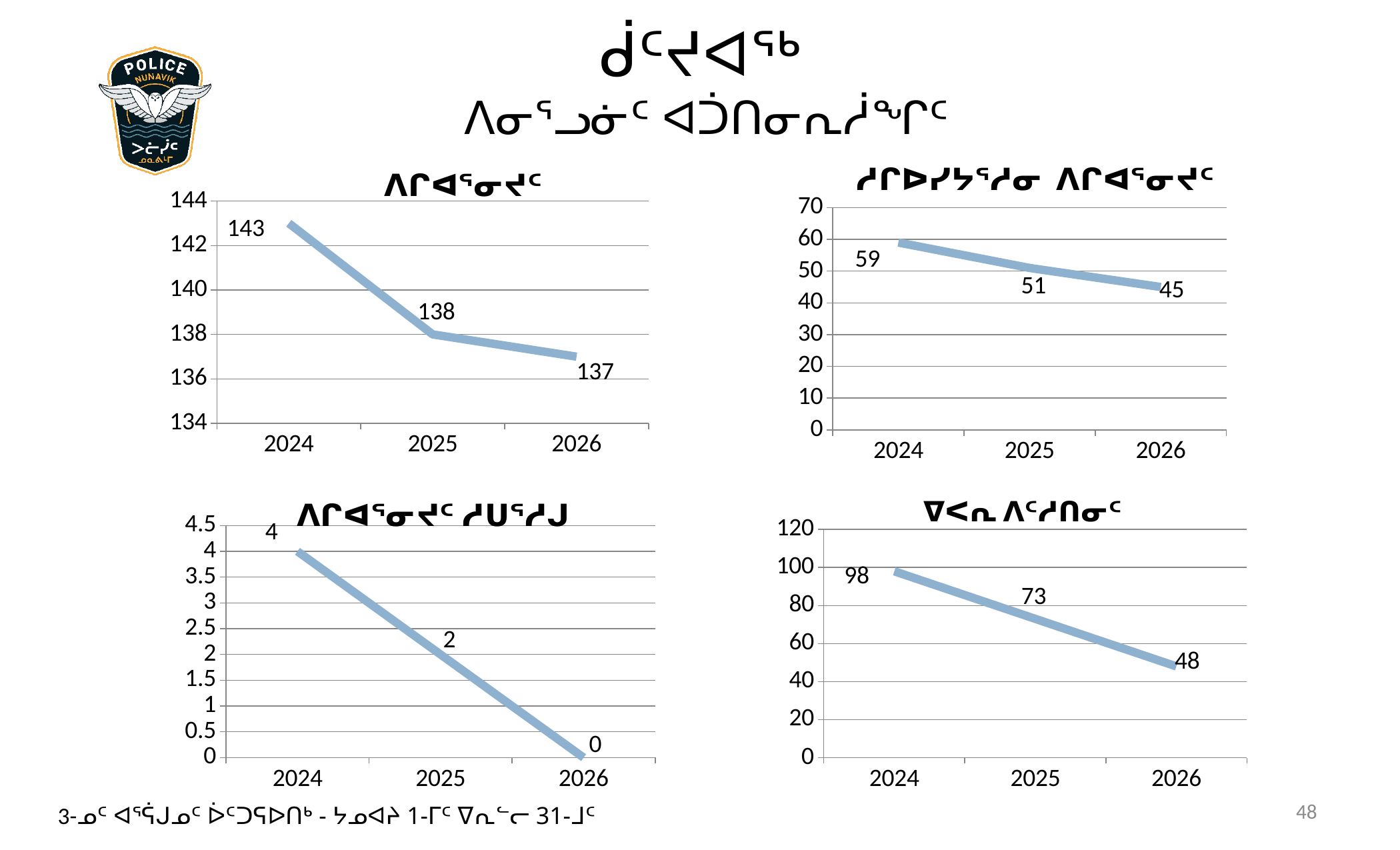
In the bottom-right chart, which year has the highest value? 2024 In the top-left chart, which year has the lowest value? 2026 What kind of chart is the bottom-right chart? line chart In the bottom-right chart, what is the value for 2026? 48 In the bottom-left chart, what is the value for 2024? 4 In the top-right chart, what is the value for 2025? 51 In the top-right chart, what is the difference between the 2024 and 2026 values? 14 In the top-left chart, what is the value for 2024? 143 In the bottom-left chart, do the values rise or fall from 2024 to 2026? fall In the bottom-right chart, what is the difference between the 2024 and 2025 values? 25 In the top-left chart, which is larger, the value for 2025 or the value for 2026? 2025 How many data points are plotted in the top-right chart? 3